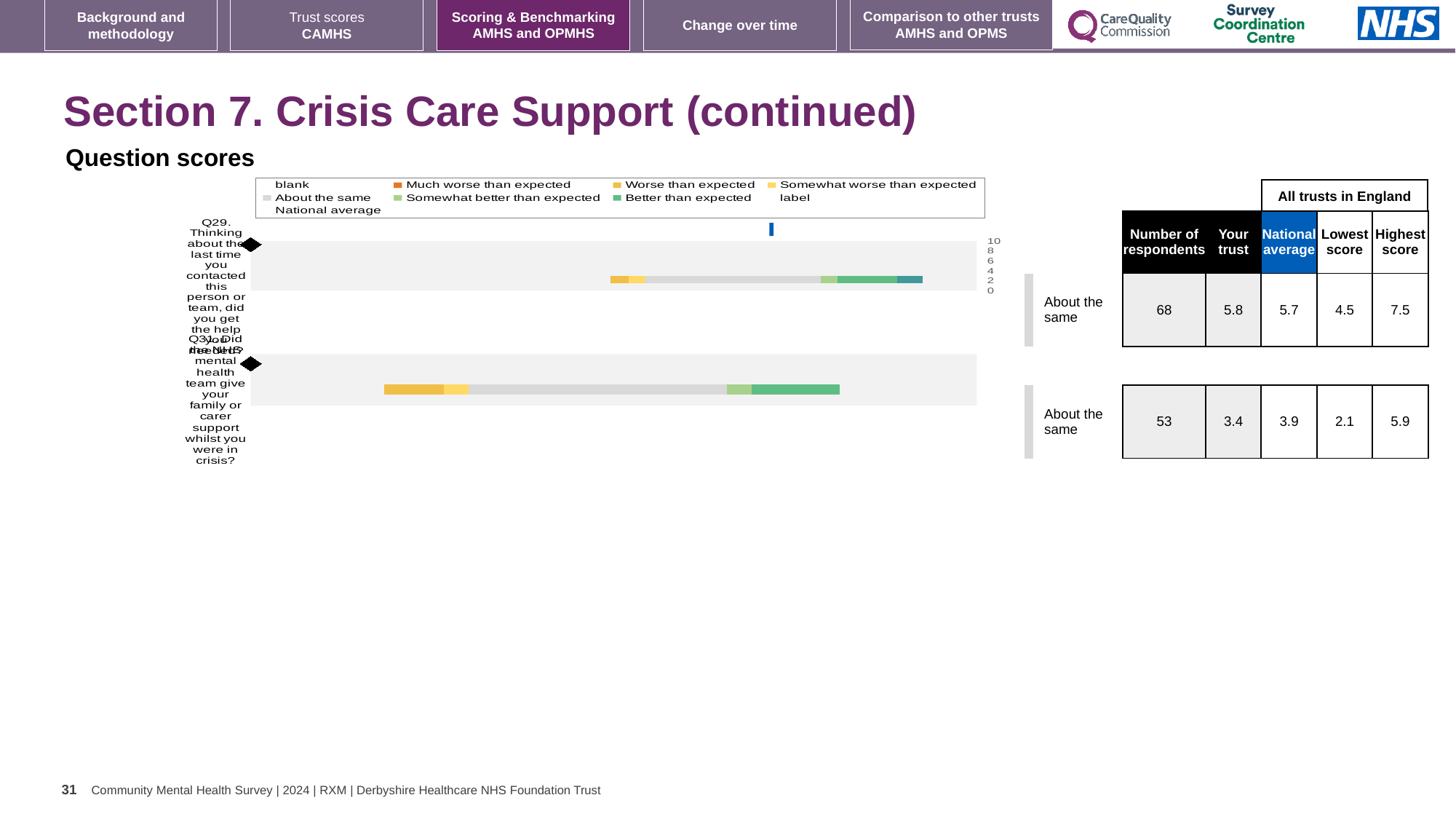
Which question has the higher 'Your trust' score, Q29 or Q31? Q29 What is the difference between the highest and lowest scores for Q31? 3.8 How much higher is the highest score than the trust's score for Q29? 1.7 What is the national average score for Q31 (support for family or carer whilst in crisis)? 3.9 What kind of chart is shown under 'Question scores'? bar chart What is the lowest score among all trusts in England for Q31? 2.1 What benchmark category is shown for both Q29 and Q31? About the same How many questions (bars) are plotted in the chart? 2 How many respondents answered Q29? 68 For Q29, which is higher: the trust's score or the national average? Your trust According to the legend, what does the blue vertical marker on the chart represent? National average What is the 'Your trust' score for Q29 (did you get the help you needed)? 5.8